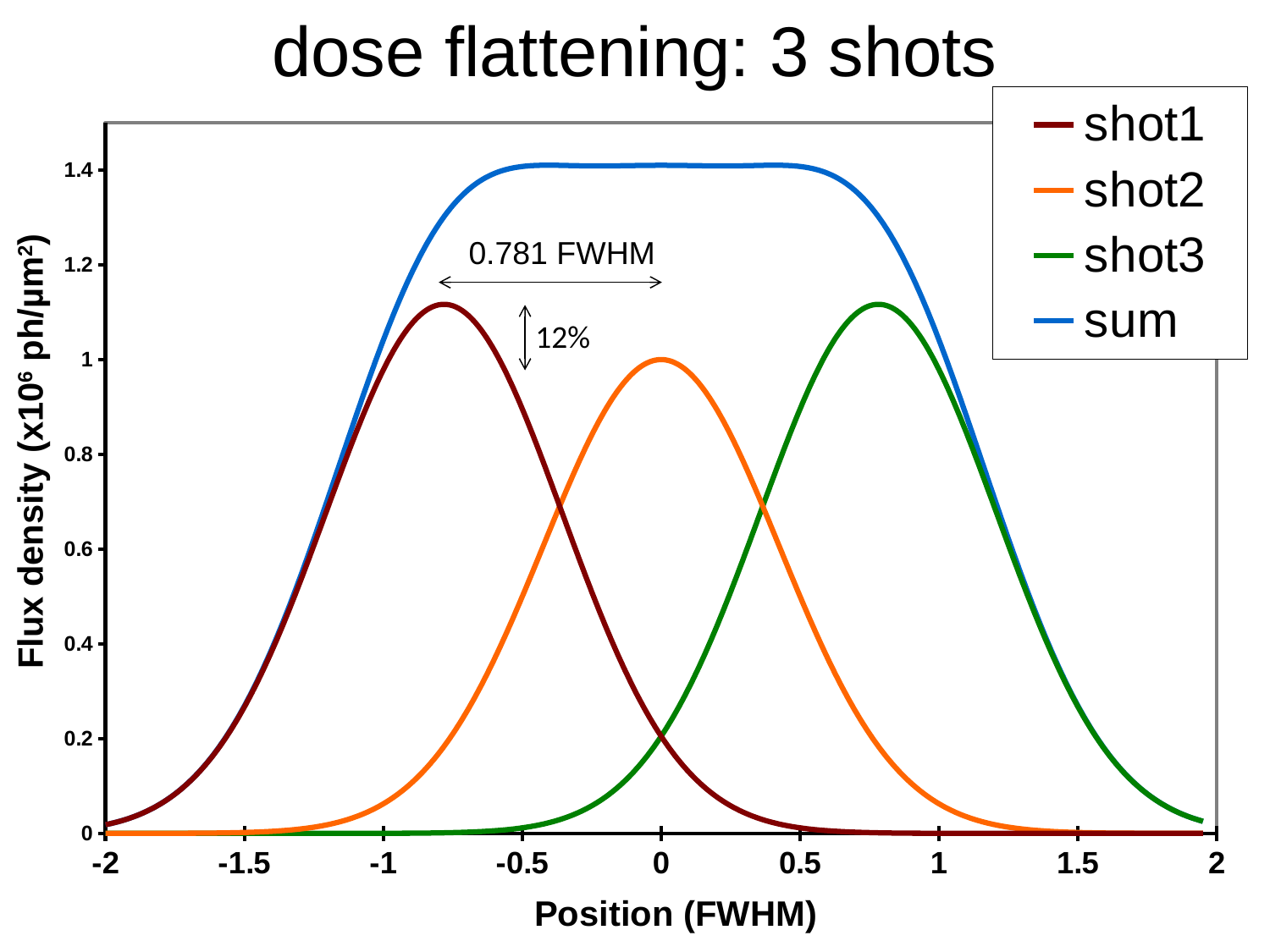
Is the value of shot3 at position -0.5 greater or less than 0.2? less Which series reaches the highest flux density? sum What kind of chart is shown on the slide? line chart What is the title of the chart? dose flattening: 3 shots At position 0, which is larger: sum or shot2? sum Is the value of sum at position 0 greater or less than 1.2? greater What is the peak flux density of shot2, at position 0? 1 Does the shot3 curve rise or fall between position 1 and position 2? fall Is the value of shot1 at position 0.5 greater or less than 0.2? less At position -1, which is larger: shot1 or shot3? shot1 What peak spacing is annotated between the shot1 and shot2 peaks? 0.781 FWHM How many series does the legend list? 4